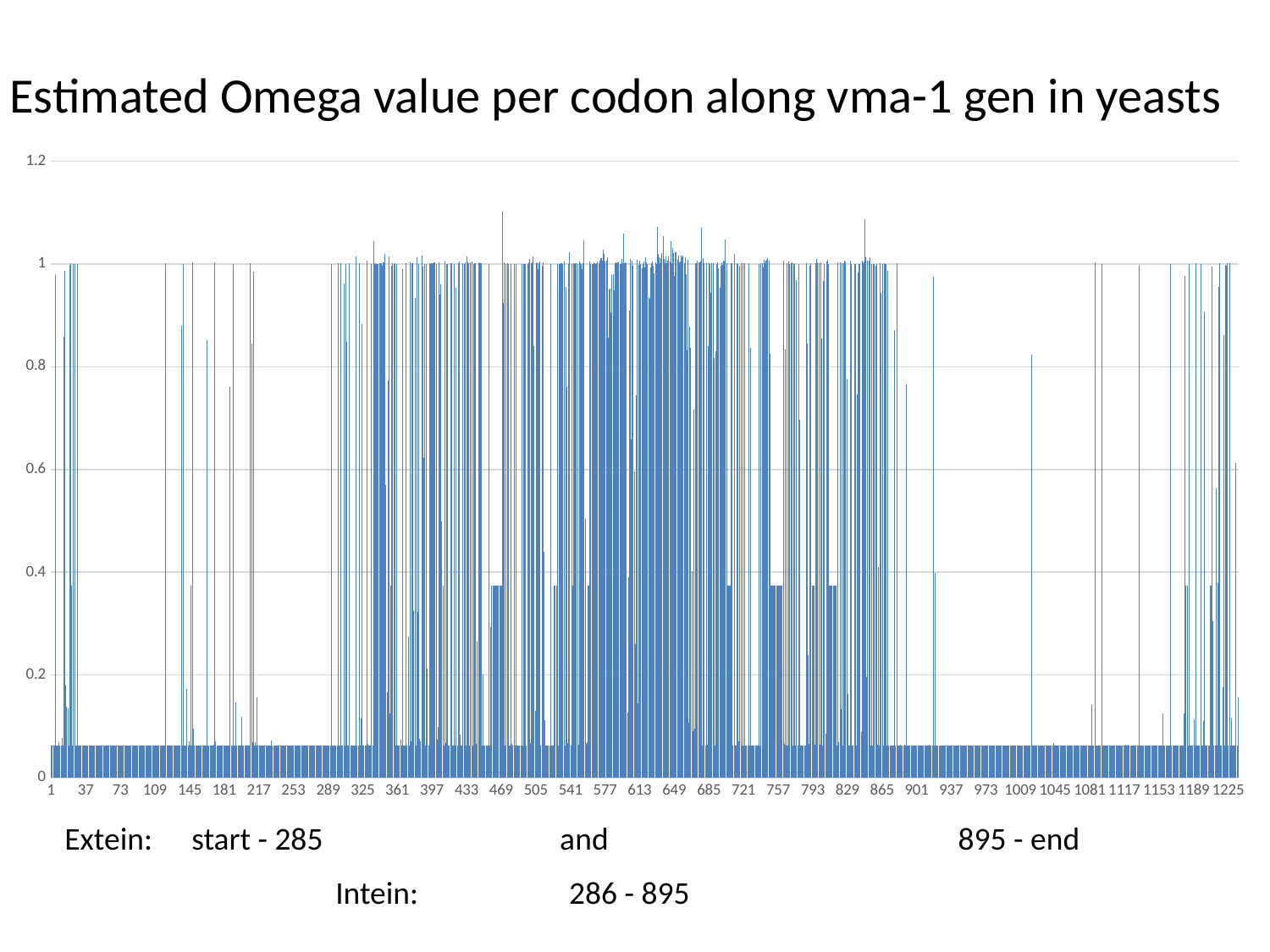
Is the highest bar on the chart greater or less than 1.2? less Are most of the bars between codons 901 and 1153 greater or less than 0.2? less What is the title of the chart? Estimated Omega value per codon along vma-1 gen in yeasts Is the tallest bar on the chart (near codon 469) greater or less than 1? greater How many tick labels are shown along the horizontal axis of the chart? 35 What kind of chart is shown on the slide? bar chart What is the highest value labelled on the vertical axis of the chart? 1.2